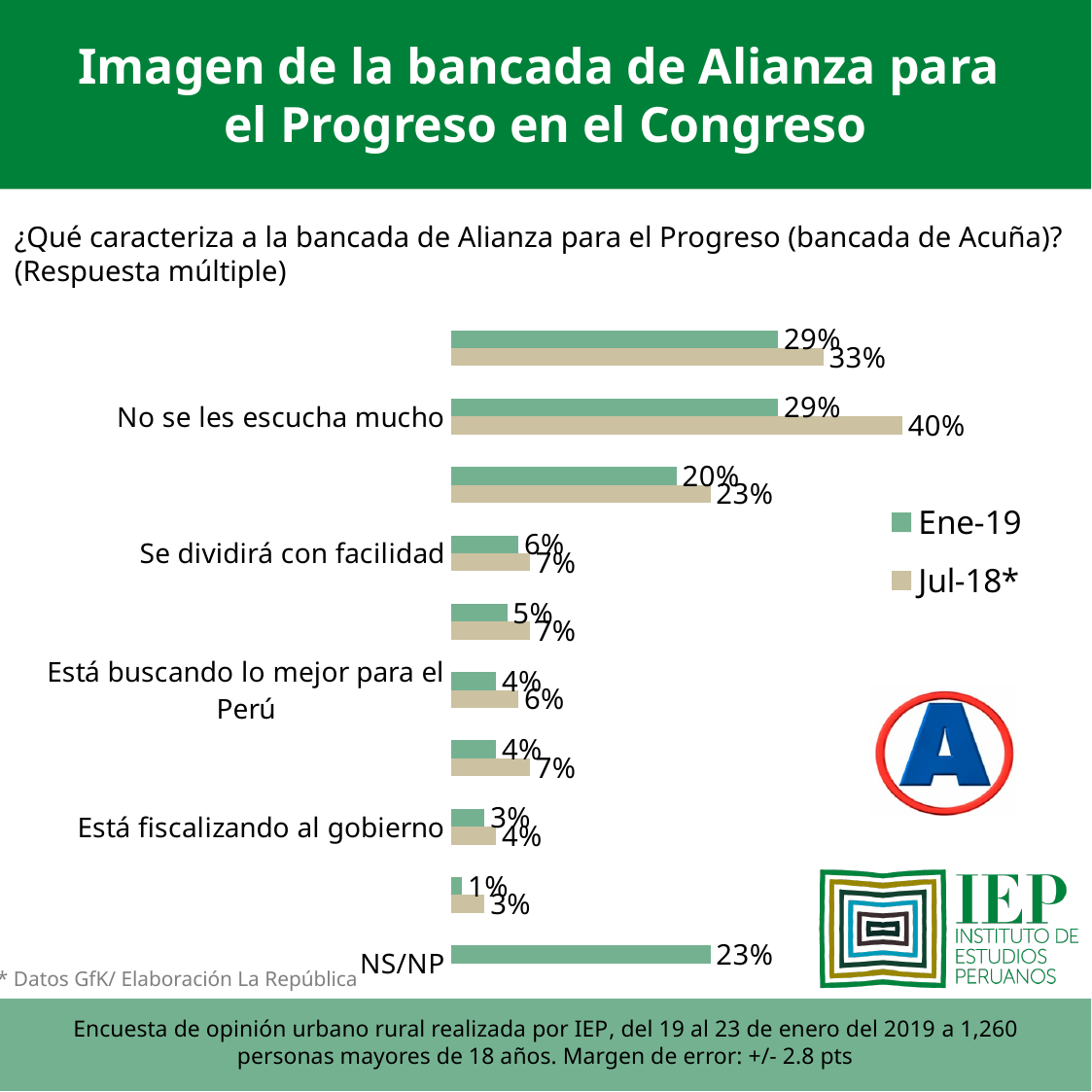
What is the Ene-19 value for "No se les escucha mucho"? 29% For "Está buscando lo mejor para el Perú", which series has the larger value, Ene-19 or Jul-18*? Jul-18* What is the Jul-18* value for "Se dividirá con facilidad"? 7% What is the Ene-19 value for "Está buscando lo mejor para el Perú"? 4% By how many percentage points does the Jul-18* value exceed the Ene-19 value for "No se les escucha mucho"? 11 What is the Ene-19 value for "NS/NP"? 23% What kind of chart is shown on the slide? Bar chart What is the Ene-19 value for "Está fiscalizando al gobierno"? 3% What is the Jul-18* value for "No se les escucha mucho"? 40% Which category has the highest Jul-18* value? No se les escucha mucho What are the two series named in the legend? Ene-19 and Jul-18* How many series does the legend list? 2